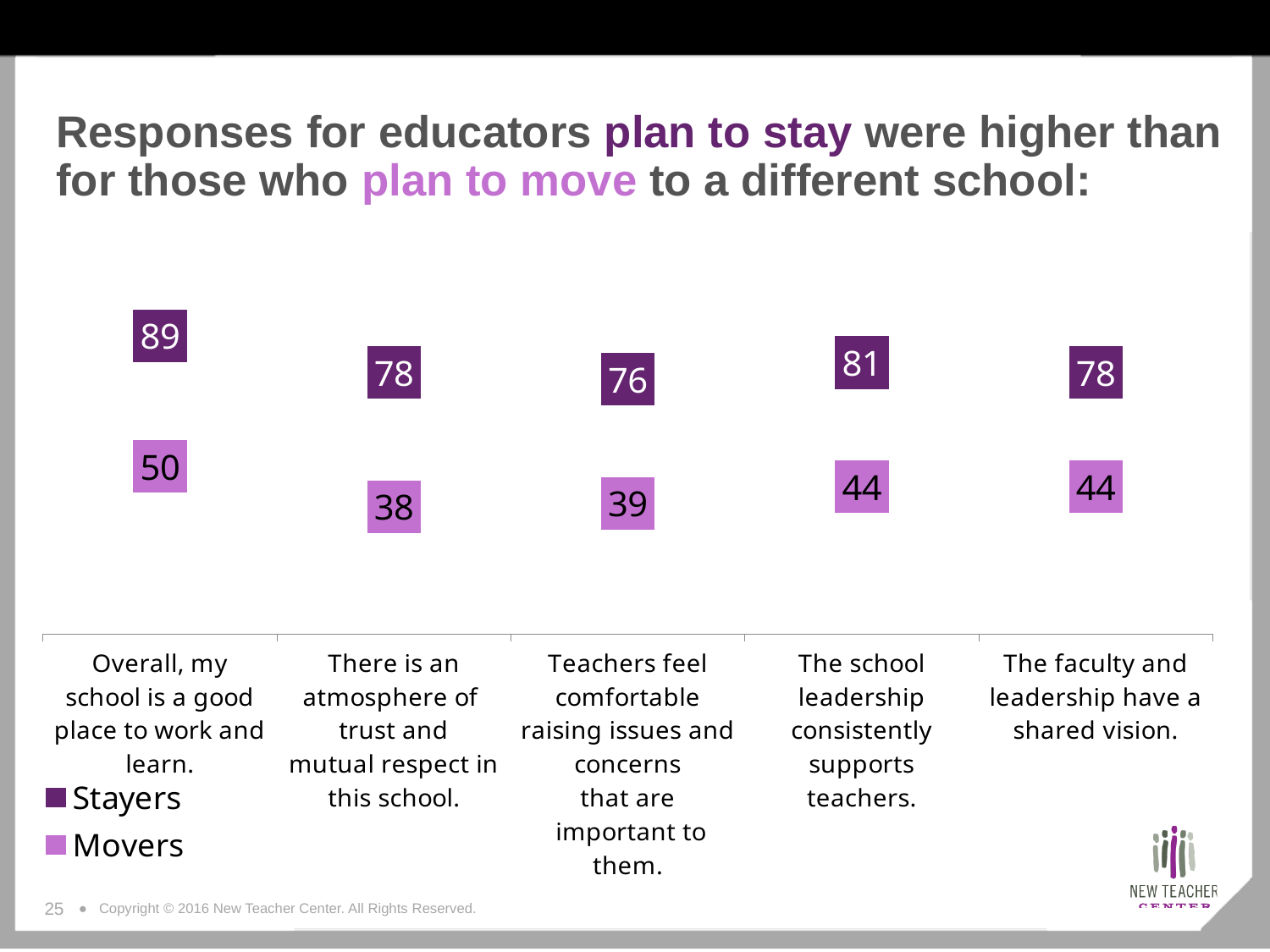
How many series does the legend list? 2 What are the two series named in the legend? Stayers and Movers What is the Stayers value for "The school leadership consistently supports teachers."? 81 What is the Movers value for "The faculty and leadership have a shared vision."? 44 What is the Movers value for "There is an atmosphere of trust and mutual respect in this school."? 38 How many statements (categories) are shown on the chart? 5 Which statement has the highest Stayers value? Overall, my school is a good place to work and learn. What is the difference between the Stayers and Movers values for "Overall, my school is a good place to work and learn."? 39 Which statement has the lowest Movers value? There is an atmosphere of trust and mutual respect in this school. What is the difference between the Stayers and Movers values for "Teachers feel comfortable raising issues and concerns that are important to them."? 37 What is the Stayers value for "Overall, my school is a good place to work and learn."? 89 Which is larger: the Movers value for "Overall, my school is a good place to work and learn." or the Movers value for "The school leadership consistently supports teachers."? Overall, my school is a good place to work and learn.